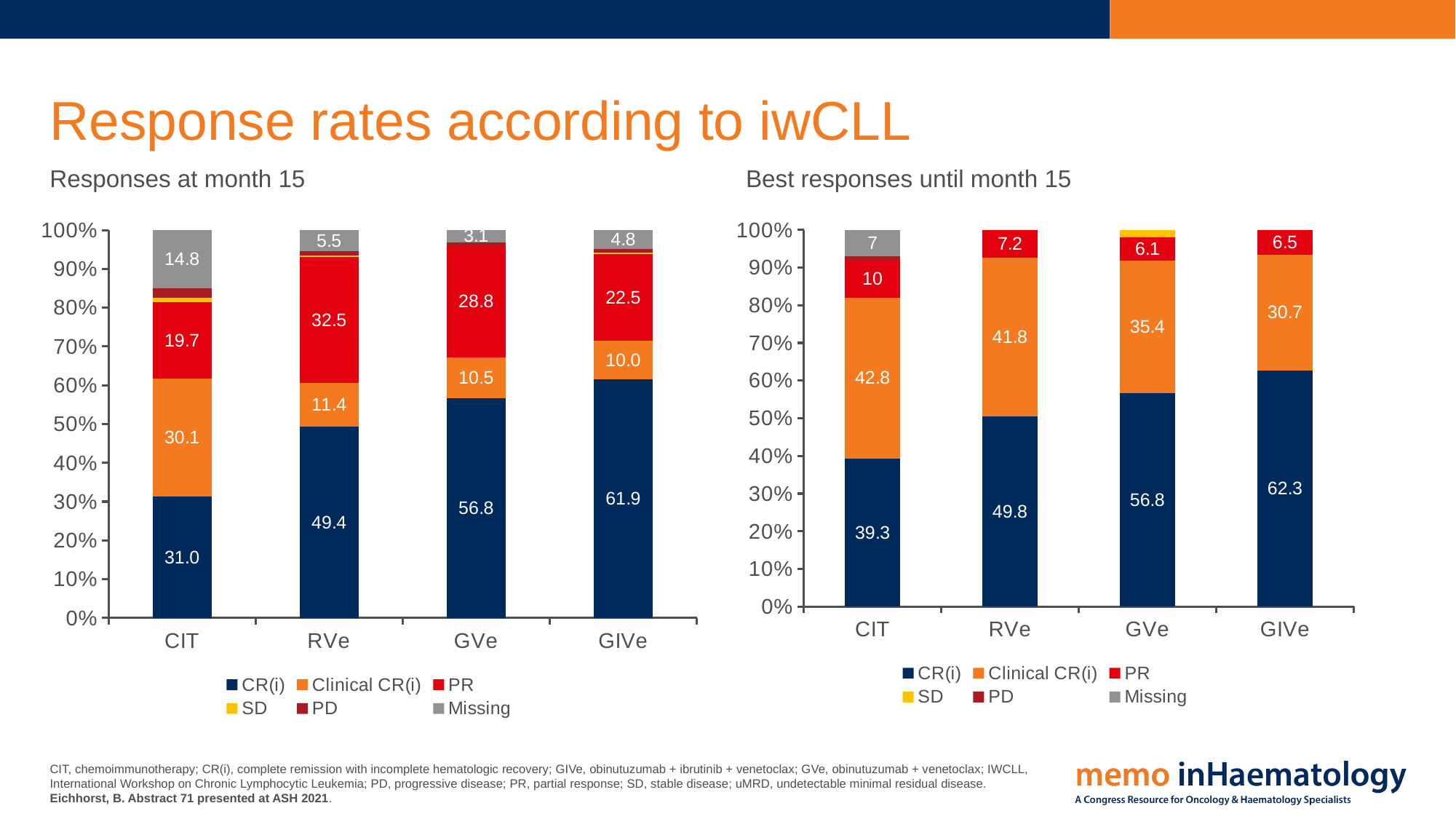
How many treatment arms are shown on the x axis of the 'Best responses until month 15' chart? 4 What kind of chart is the 'Best responses until month 15' chart? Stacked bar chart In the 'Responses at month 15' chart, what is the CR(i) value for RVe? 49.4 In the 'Best responses until month 15' chart, which treatment arm has the lowest CR(i) value? CIT In the 'Responses at month 15' chart, what is the difference between the CR(i) values for GIVe and CIT? 30.9 In the 'Best responses until month 15' chart, what is the PR value for GIVe? 6.5 In the 'Responses at month 15' chart, which is larger: the PR value for RVe or the PR value for GVe? RVe In the 'Responses at month 15' chart, what is the Missing value for CIT? 14.8 In the 'Best responses until month 15' chart, what is the Clinical CR(i) value for GVe? 35.4 How many series does the legend of the 'Responses at month 15' chart list? 6 In the 'Best responses until month 15' chart, what is the difference between the Clinical CR(i) values for CIT and GIVe? 12.1 In the 'Responses at month 15' chart, which treatment arm has the highest CR(i) value? GIVe